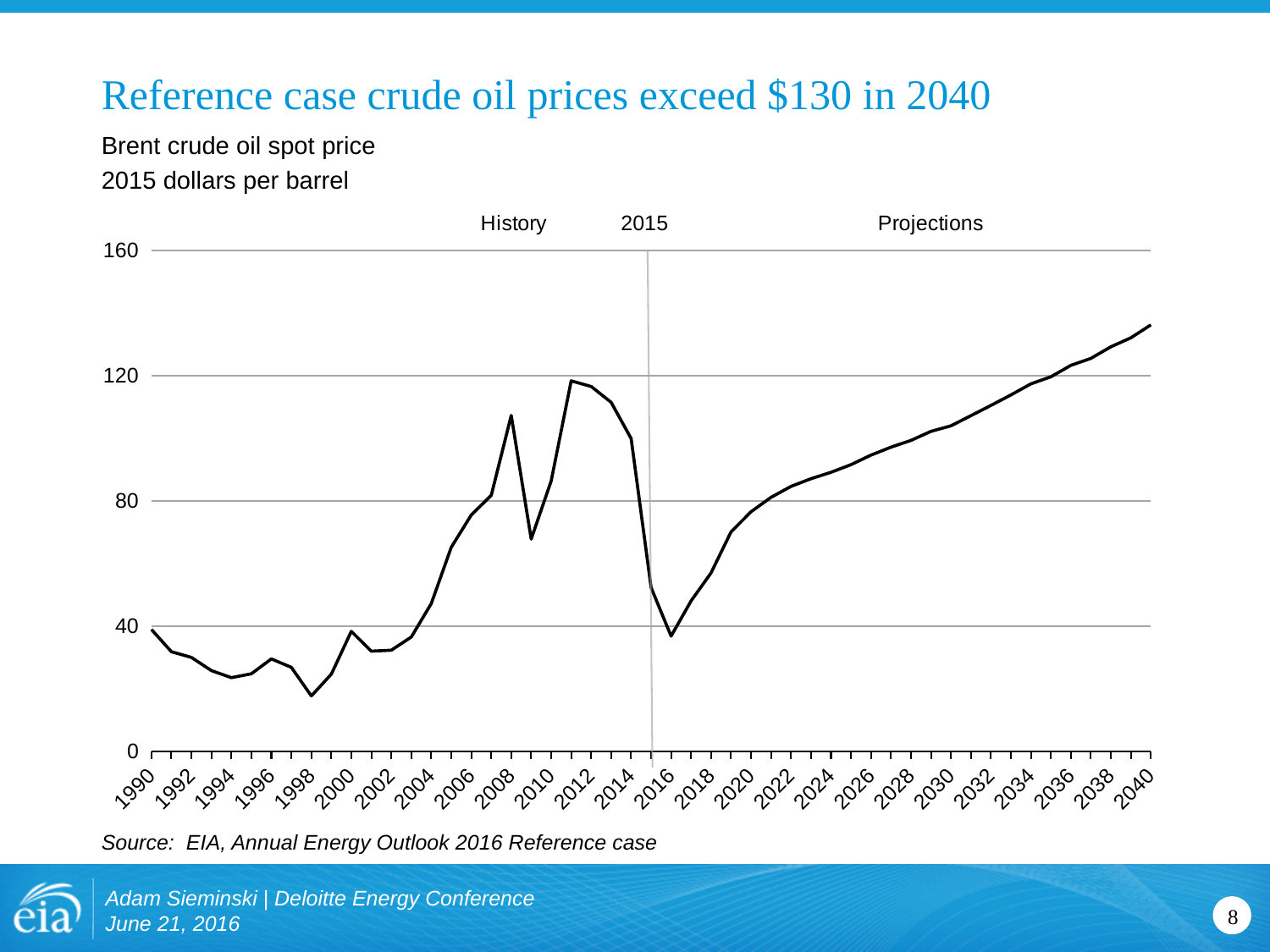
Which year has the higher price, 2008 or 2016? 2008 Is the value for 2016 greater or less than 40? less Is the value for 1998 greater or less than 40? less In which year does the Brent crude oil spot price reach its highest value on the chart? 2040 What unit is the Brent crude oil spot price measured in on this chart? 2015 dollars per barrel Is the value for 2040 greater or less than 120? greater In which year is the Brent crude oil spot price at its lowest on the chart? 1998 Which year separates the History and Projections sections of the chart? 2015 Do the projected prices rise or fall from 2016 to 2040? rise What kind of chart is shown on the slide? line chart